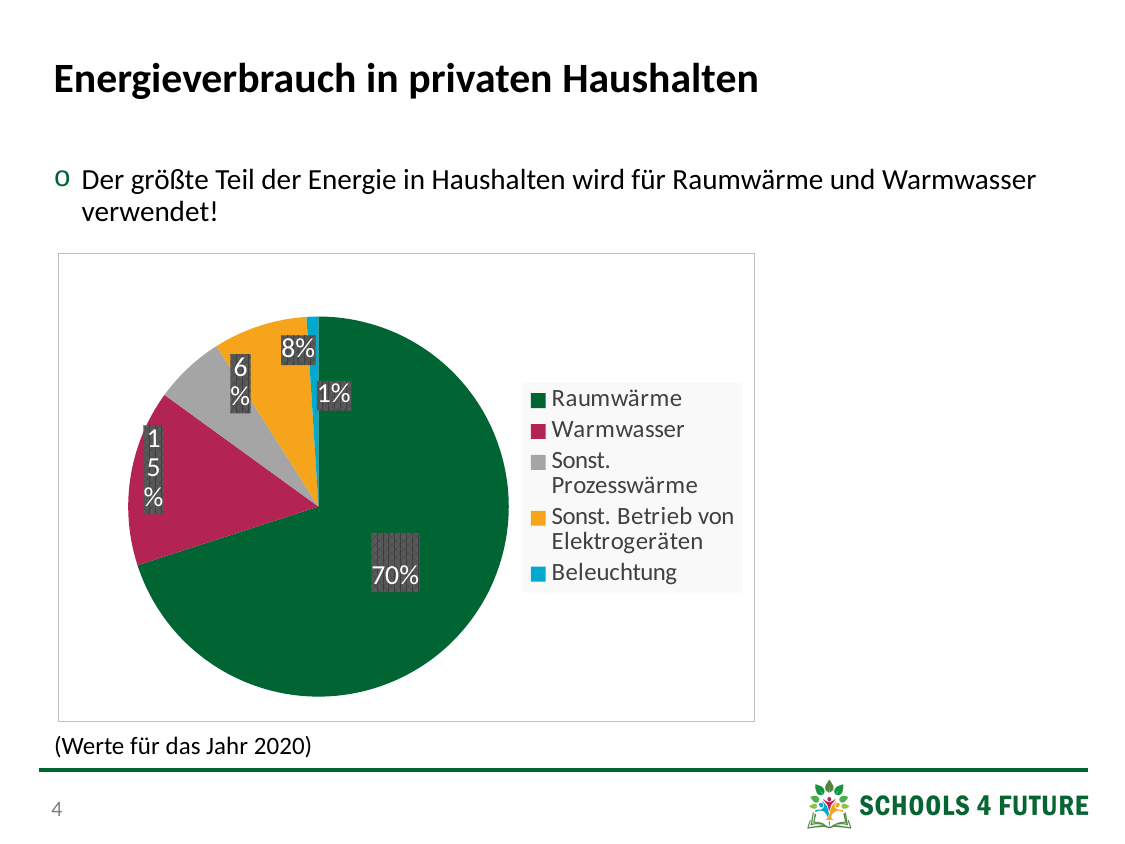
What is the difference in percentage points between Raumwärme and Warmwasser? 55 Which category has the smallest slice of the pie? Beleuchtung What share of the pie does Raumwärme have? 70% Which category has the largest slice of the pie? Raumwärme What share of the pie does Beleuchtung have? 1% What share of the pie does Warmwasser have? 15% What share of the pie does Sonst. Prozesswärme have? 6% Which is larger, the share for Sonst. Betrieb von Elektrogeräten or the share for Sonst. Prozesswärme? Sonst. Betrieb von Elektrogeräten How many categories does the pie chart show? 5 Which colour represents Warmwasser in the pie chart? red What kind of chart is shown on the slide? pie chart What share of the pie does Sonst. Betrieb von Elektrogeräten have? 8%